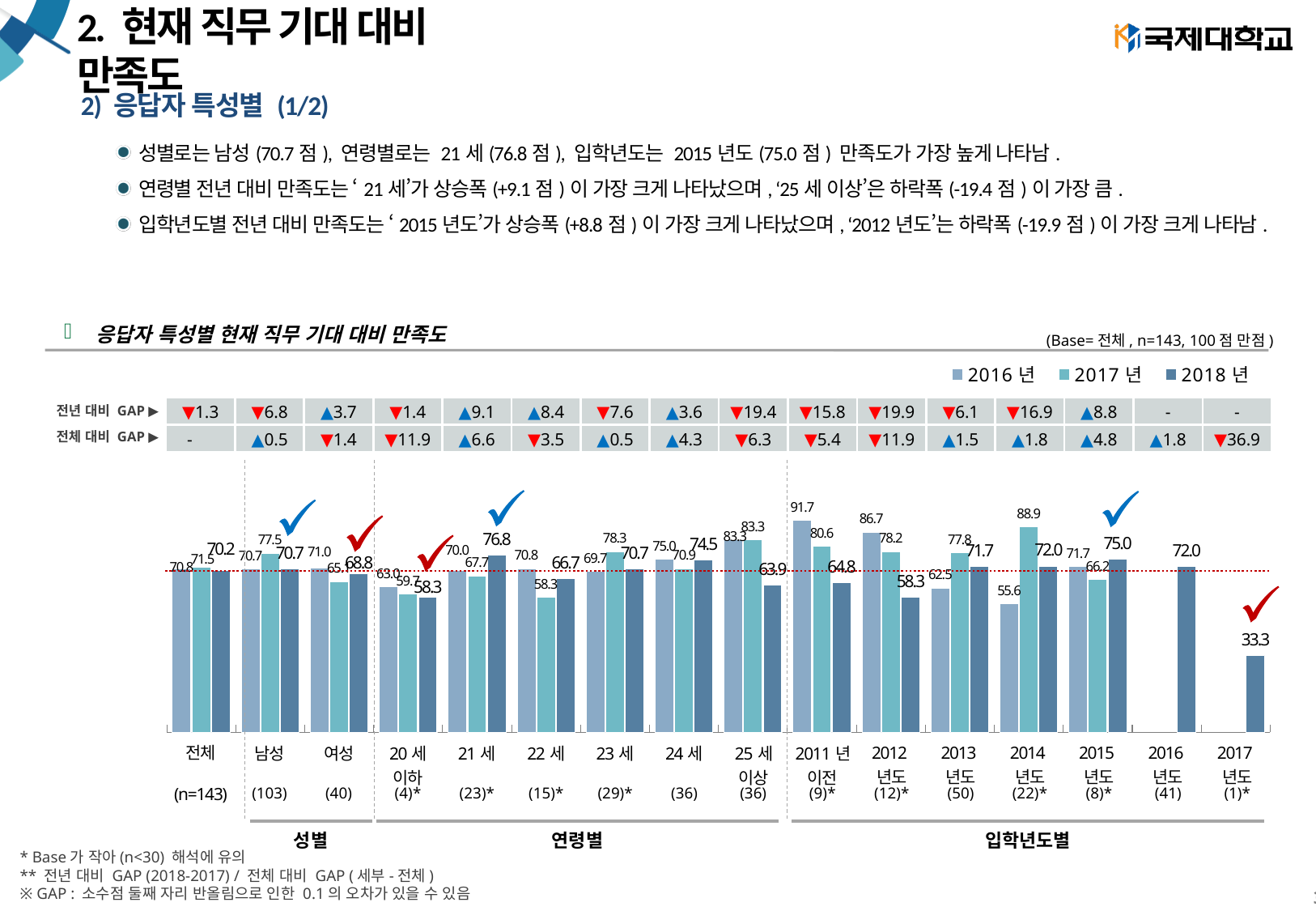
Which has the larger 2016년 value, 2011년 이전 or 2012년도? 2011년 이전 Do the values for 2011년 이전 rise or fall from 2016년 to 2018년? fall Which category has the lowest 2018년 value in the chart? 2017년도 What are the three legend entries of the chart? 2016년, 2017년, 2018년 How many series does the legend of the chart list? 3 What is the 2016년 value for 2014년도 in the chart? 55.6 Which category has the highest 2018년 value in the chart? 21세 How many categories are shown along the x axis of the chart? 16 What is the 2017년 value for 2014년도 in the chart? 88.9 What is the difference between the 2018년 values for 남성 and 여성? 1.9 What is the 2018년 value for 21세 in the chart? 76.8 What kind of chart is used to show 응답자 특성별 현재 직무 기대 대비 만족도? bar chart